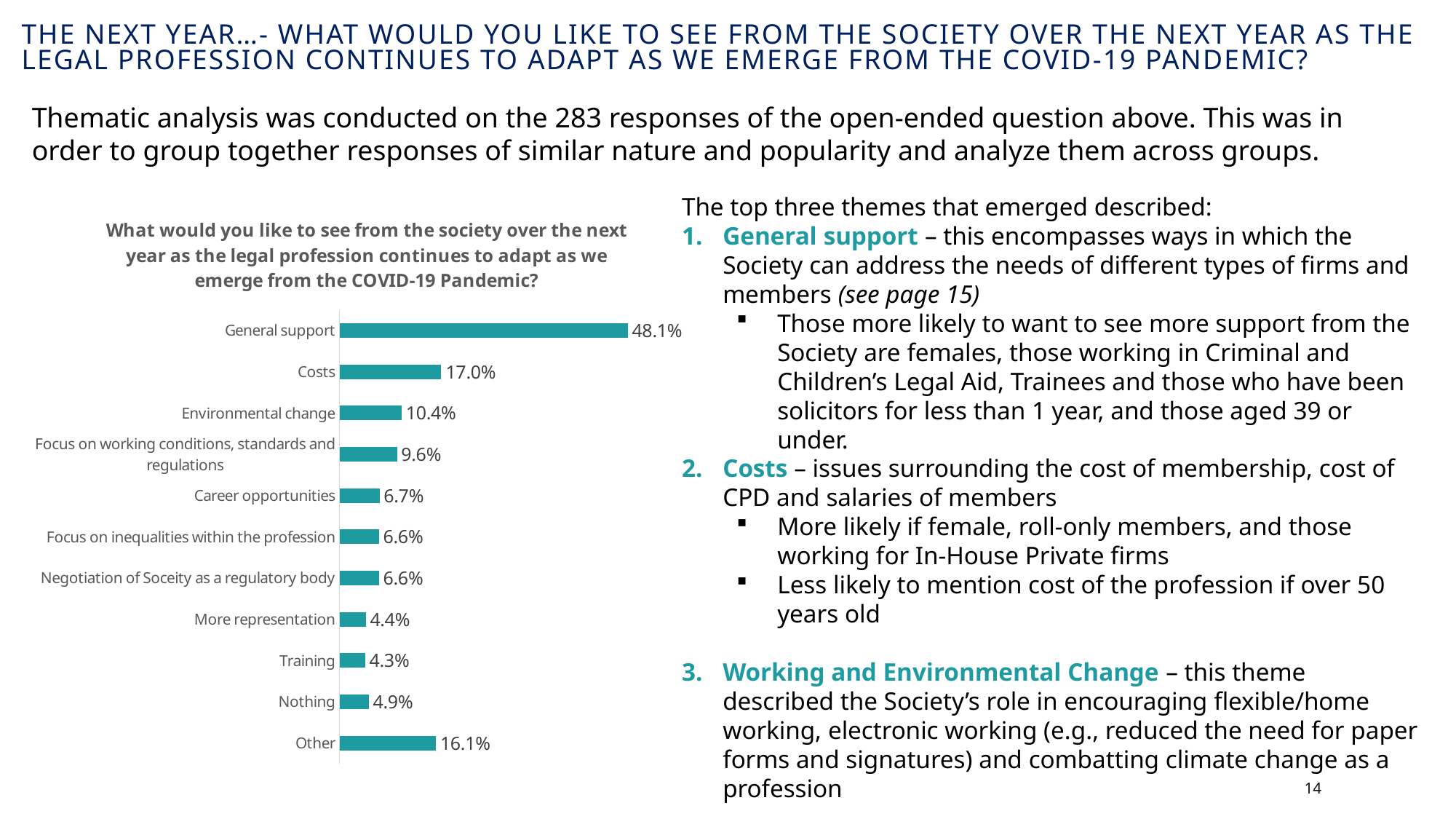
Which is larger, Nothing or Training? Nothing Which category has the highest value? General support What is the value for Focus on working conditions, standards and regulations? 9.6% Which category has the lowest value? Training What is the value shown for Costs? 17.0% What is the value for Other? 16.1% What is the difference between General support and Costs? 31.1% What percentage is shown for Environmental change? 10.4% How many categories are shown in the chart? 11 What kind of chart is shown on the slide? Bar chart Which is larger, Costs or Other? Costs What percentage of responses fall under General support? 48.1%